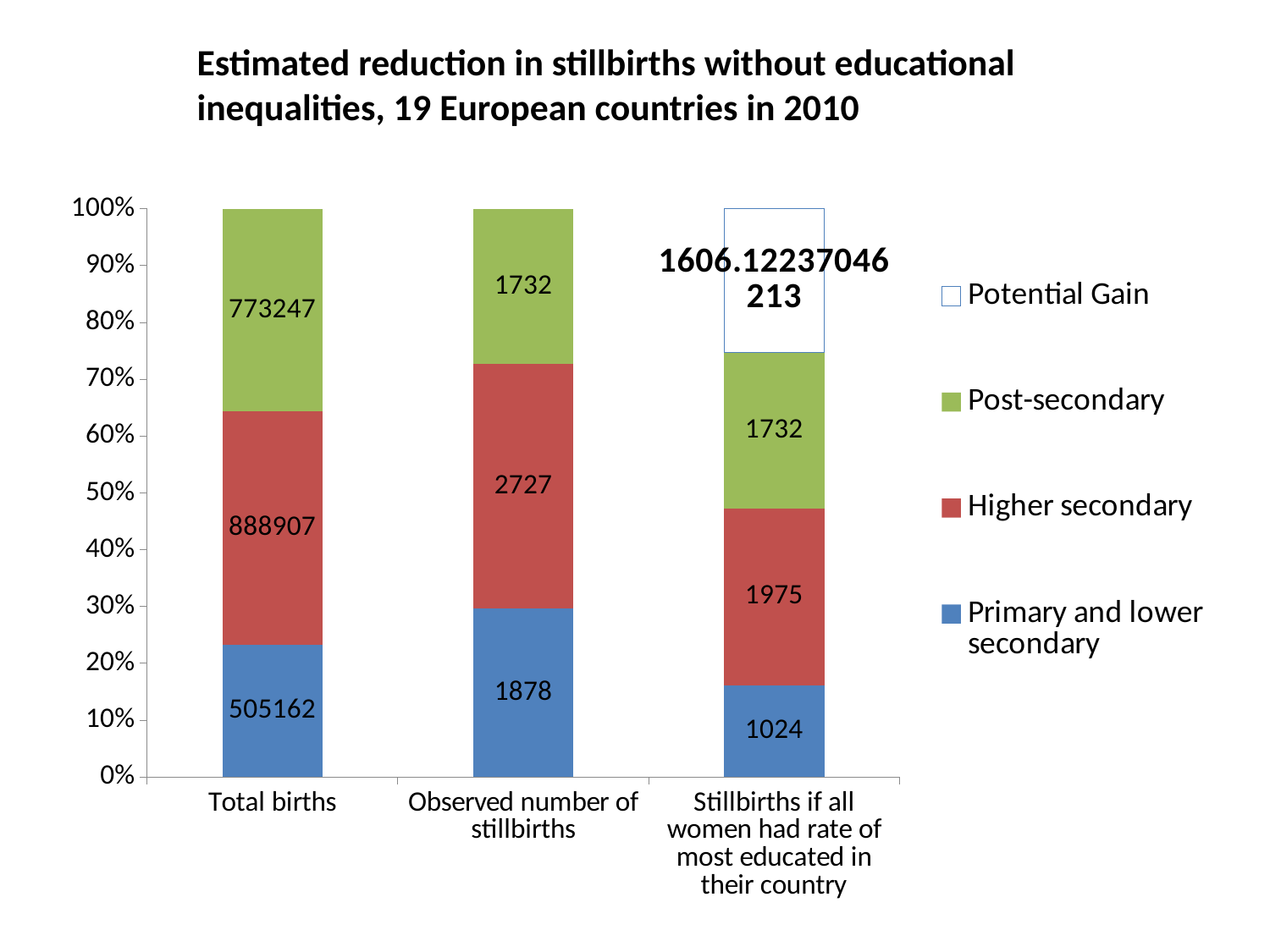
What is the value for Primary and lower secondary in the Total births bar? 505162 What is the Primary and lower secondary value in the bar for stillbirths if all women had the rate of the most educated in their country? 1024 What is the value for Higher secondary in the Observed number of stillbirths bar? 2727 What is the difference between the Higher secondary and Primary and lower secondary values in the Observed number of stillbirths bar? 849 Which is larger: the Higher secondary value for Total births or the Post-secondary value for Total births? Higher secondary (888907) Within the Total births bar, which education group has the smallest value? Primary and lower secondary How many categories are shown on the x axis? 3 Within the Observed number of stillbirths bar, which education group has the largest value? Higher secondary What kind of chart is shown on the slide? Stacked bar chart How many series does the legend list? 4 What is the Potential Gain value shown on the chart? 1606.12237046213 What is the Post-secondary value in the Total births bar? 773247